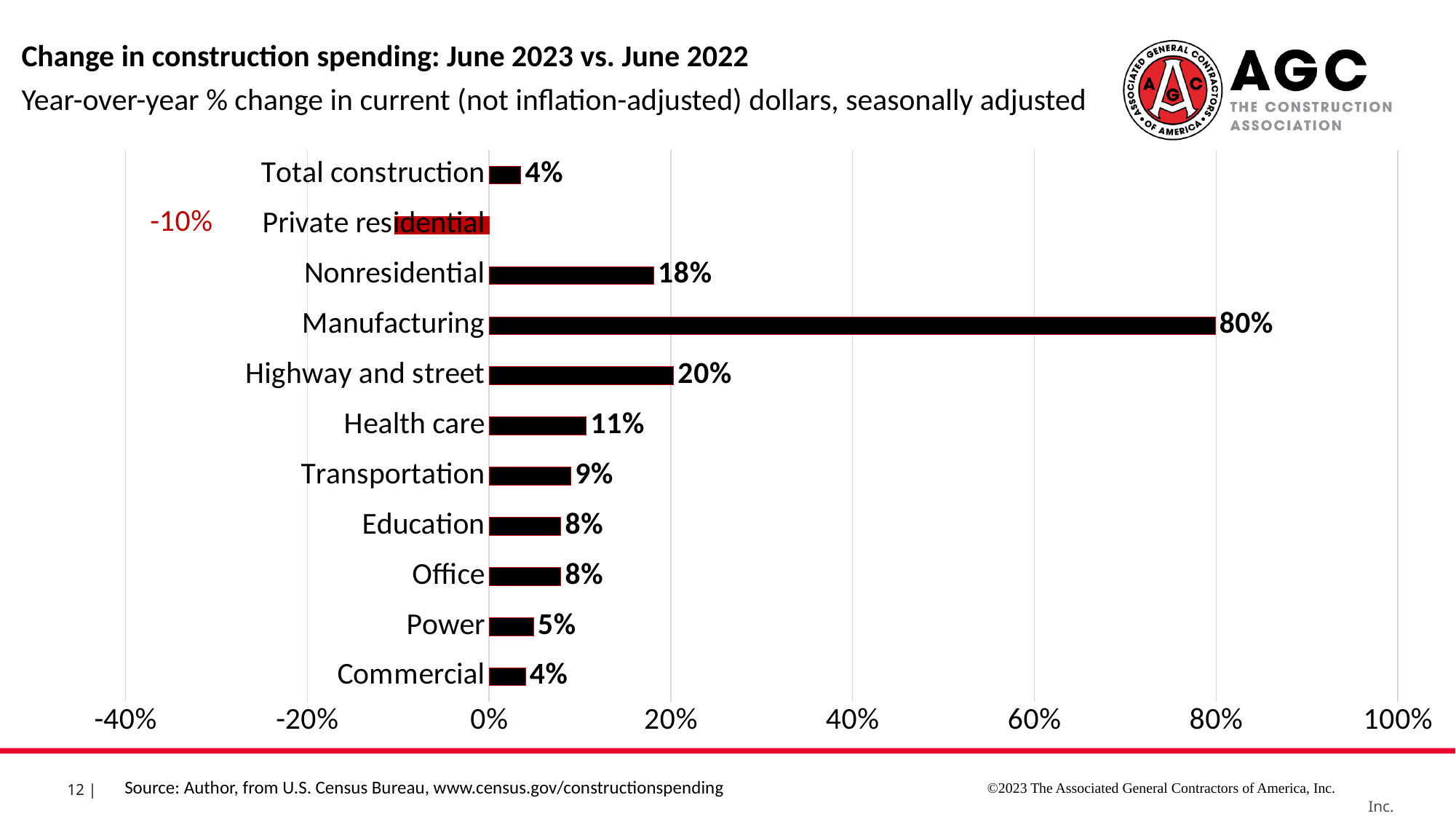
How many categories are shown in the chart? 11 What is the year-over-year % change for Private residential? -10% What is the difference between the % change for Manufacturing and Nonresidential? 62% Which category has the lowest year-over-year % change? Private residential Which category has the highest year-over-year % change? Manufacturing Which is larger, the % change for Highway and street or for Nonresidential? Highway and street What colour is the bar for Private residential? Red What is the title of the chart? Change in construction spending: June 2023 vs. June 2022 What is the year-over-year % change for Manufacturing? 80% What is the year-over-year % change for Highway and street? 20% What is the year-over-year % change for Health care? 11% What kind of chart is shown on the slide? Bar chart